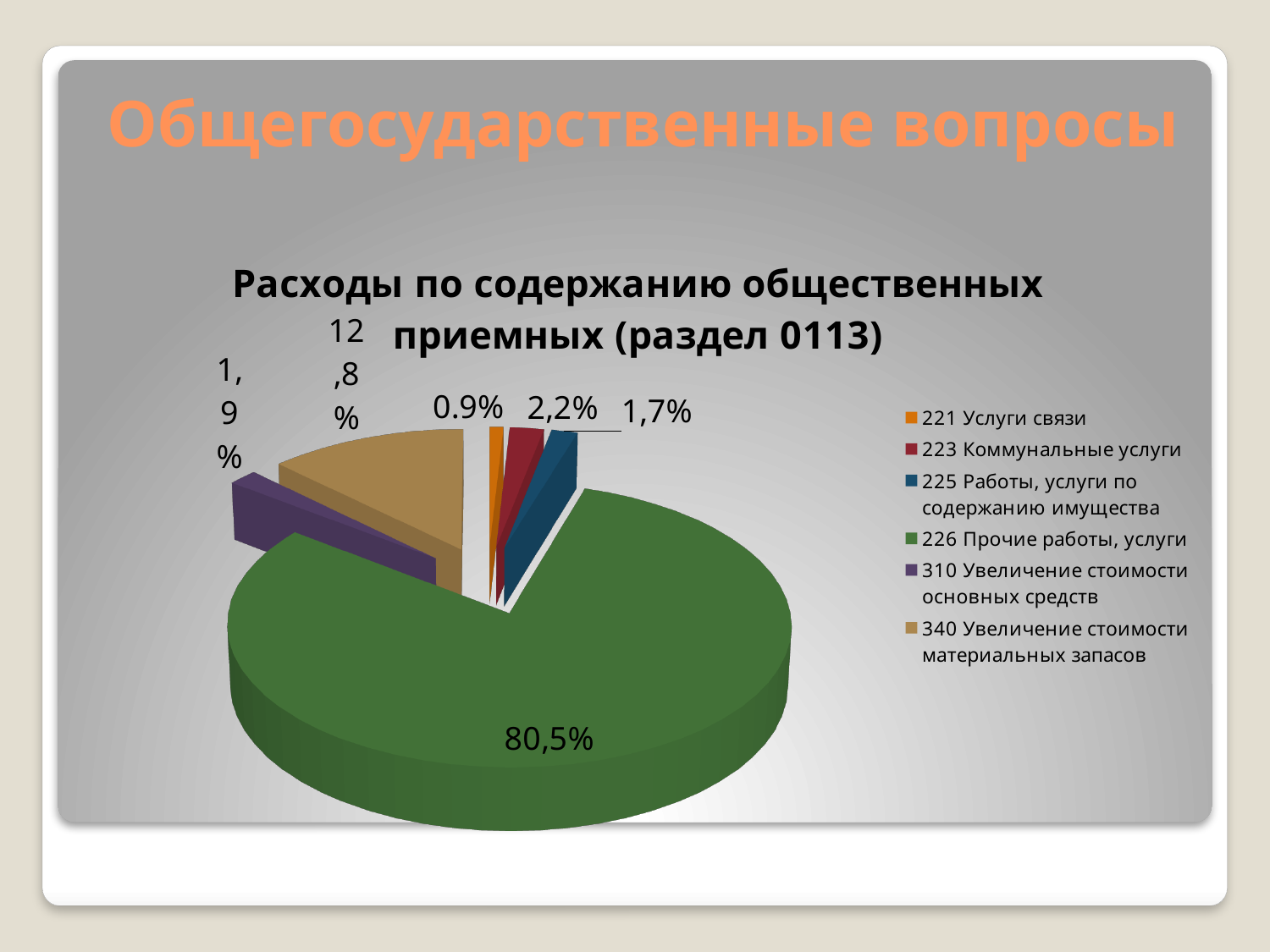
What share of the pie does "340 Увеличение стоимости материальных запасов" have? 12,8% What is the title of the chart? Расходы по содержанию общественных приемных (раздел 0113) What is the value shown for "225 Работы, услуги по содержанию имущества"? 1,7% What is the value shown for "310 Увеличение стоимости основных средств"? 1,9% Which category has the smallest slice of the pie? 221 Услуги связи Which category has the largest slice of the pie? 226 Прочие работы, услуги How many categories does the legend of the pie chart list? 6 What is the value shown for "223 Коммунальные услуги"? 2,2% Which is larger, the share of "223 Коммунальные услуги" or the share of "225 Работы, услуги по содержанию имущества"? 223 Коммунальные услуги What is the difference between the shares of "226 Прочие работы, услуги" and "340 Увеличение стоимости материальных запасов"? 67,7% What kind of chart is shown on the slide? pie chart What share of the pie does "226 Прочие работы, услуги" have? 80,5%